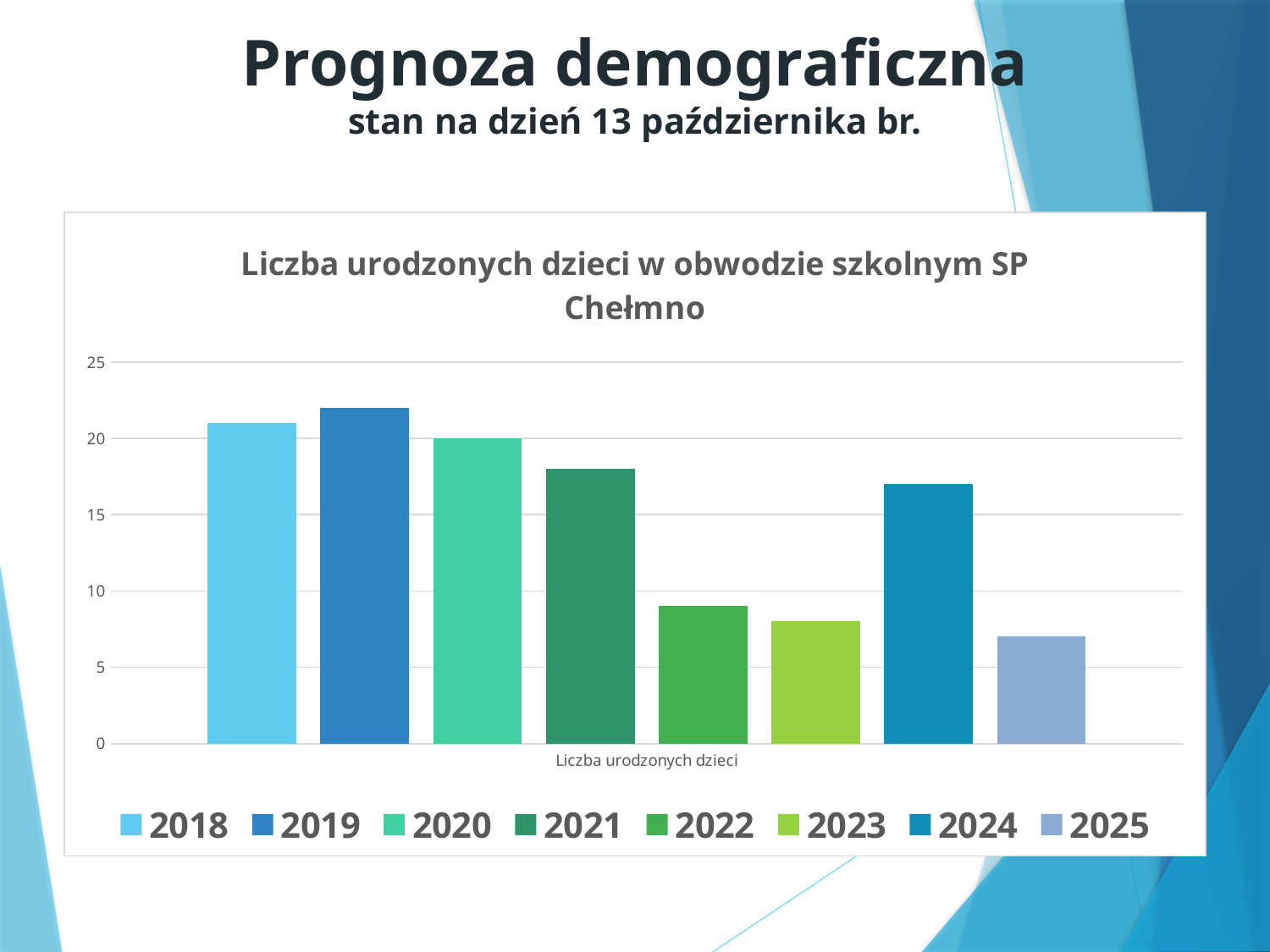
Which year has the highest value? 2019 How many series does the legend list? 8 Is the value for 2024 greater or less than 15? greater Is the value for 2018 greater or less than 20? greater Is the value for 2022 greater or less than 10? less Which year has the lowest value? 2025 Which is larger, the value for 2022 or the value for 2024? 2024 What kind of chart is shown on the slide? bar chart What is the value for 2020? 20 How many bars are plotted in the chart? 8 What is the title of the chart? Liczba urodzonych dzieci w obwodzie szkolnym SP Chełmno Which is larger, the value for 2018 or the value for 2023? 2018